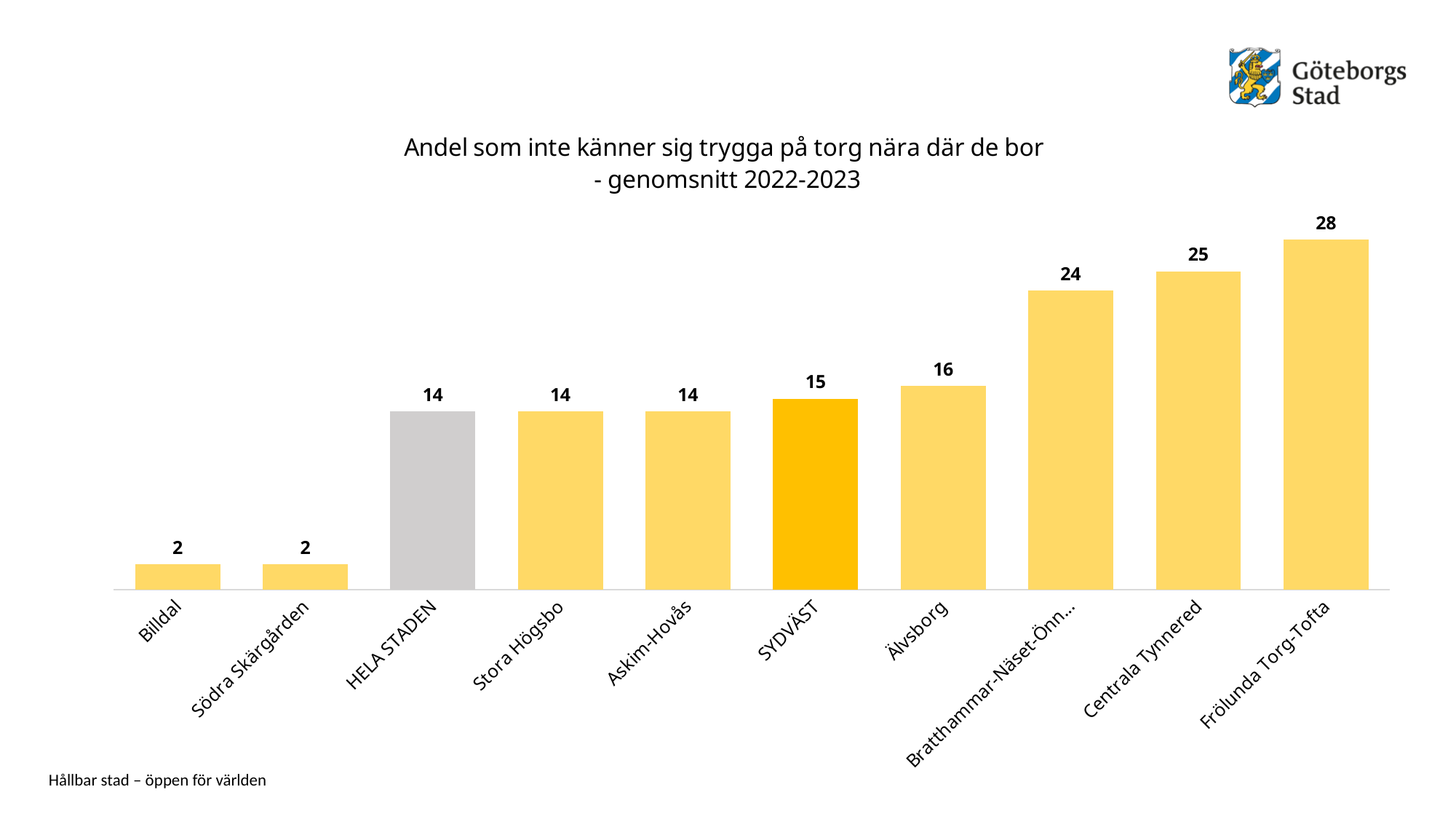
What is the value for SYDVÄST? 15 What is the difference between the values for Frölunda Torg-Tofta and Billdal? 26 What is the value for HELA STADEN? 14 Which category has the highest value? Frölunda Torg-Tofta What is the value for Frölunda Torg-Tofta? 28 Which is larger, the value for Älvsborg or the value for Askim-Hovås? Älvsborg How many categories are shown on the x axis? 10 What is the value for Centrala Tynnered? 25 Do the values generally rise or fall from left to right along the x axis? Rise What kind of chart is shown on the slide? Bar chart What is the difference between the values for Centrala Tynnered and Älvsborg? 9 Which bar is coloured grey rather than yellow? HELA STADEN